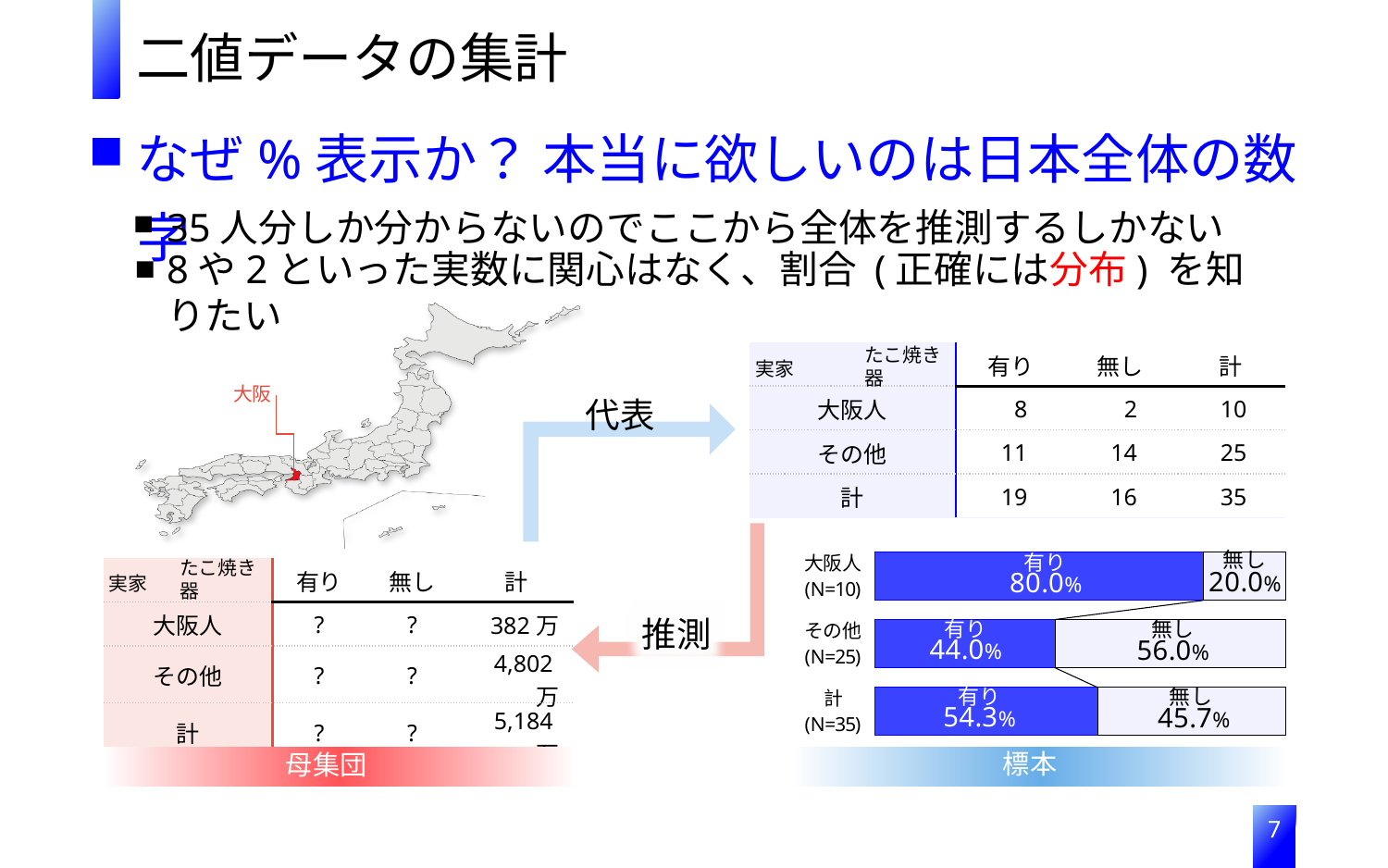
In the stacked bar chart on the right, what is the 有り value for 大阪人 (N=10)? 80.0% In the stacked bar chart on the right, how many bars (categories) are shown? 3 In the stacked bar chart on the right, what is the 無し value for 計 (N=35)? 45.7% In the stacked bar chart on the right, what is the 無し value for その他 (N=25)? 56.0% In the stacked bar chart on the right, what is the total of the 有り and 無し segments for 計 (N=35)? 100.0% In the stacked bar chart on the right, which category has the highest 有り share? 大阪人 (N=10) In the stacked bar chart on the right, is the 無し share larger for 大阪人 (N=10) or for その他 (N=25)? その他 (N=25) In the stacked bar chart on the right, what is the 有り value for 計 (N=35)? 54.3% What type of chart is shown on the right side of the slide? Stacked bar chart In the stacked bar chart on the right, what is the difference between the 有り share for 大阪人 (N=10) and the 有り share for その他 (N=25)? 36.0% In the stacked bar chart on the right, which category has the lowest 有り share? その他 (N=25) In the stacked bar chart on the right, how many segments (series) make up each bar? 2